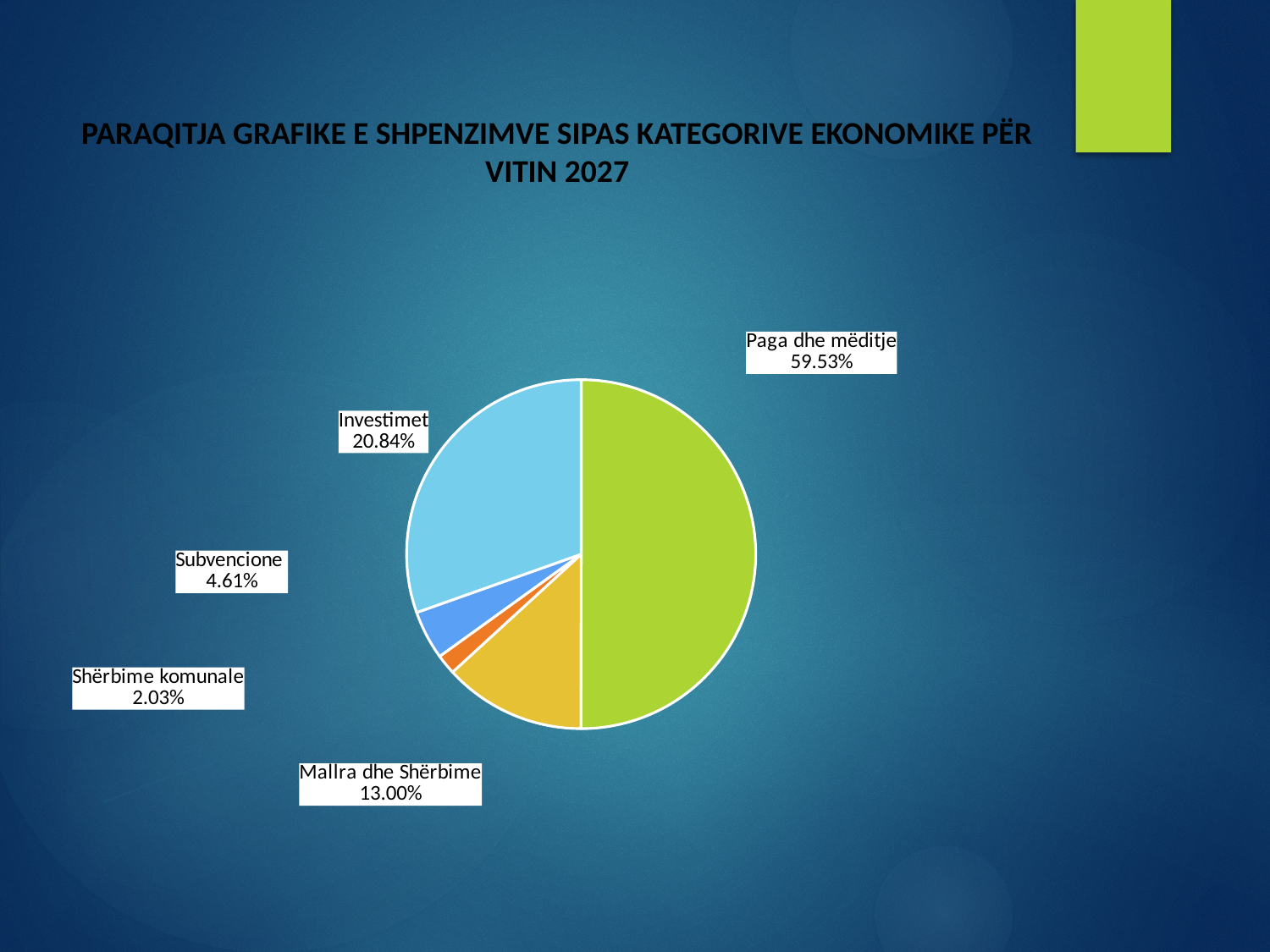
What is the value shown for Shërbime komunale? 2.03% What is the title of the chart on the slide? PARAQITJA GRAFIKE E SHPENZIMVE SIPAS KATEGORIVE EKONOMIKE PËR VITIN 2027 What is the value shown for Subvencione? 4.61% What is the value shown for Investimet? 20.84% What kind of chart is shown on the slide? Pie chart What share of the pie does Paga dhe mëditje represent? 59.53% Which is larger, the share for Investimet or the share for Mallra dhe Shërbime? Investimet How many categories are shown in the pie chart? 5 Which category has the smallest share of the pie? Shërbime komunale What is the value shown for Mallra dhe Shërbime? 13.00% Which category has the largest share of the pie? Paga dhe mëditje What is the difference in percentage points between Paga dhe mëditje and Investimet? 38.69